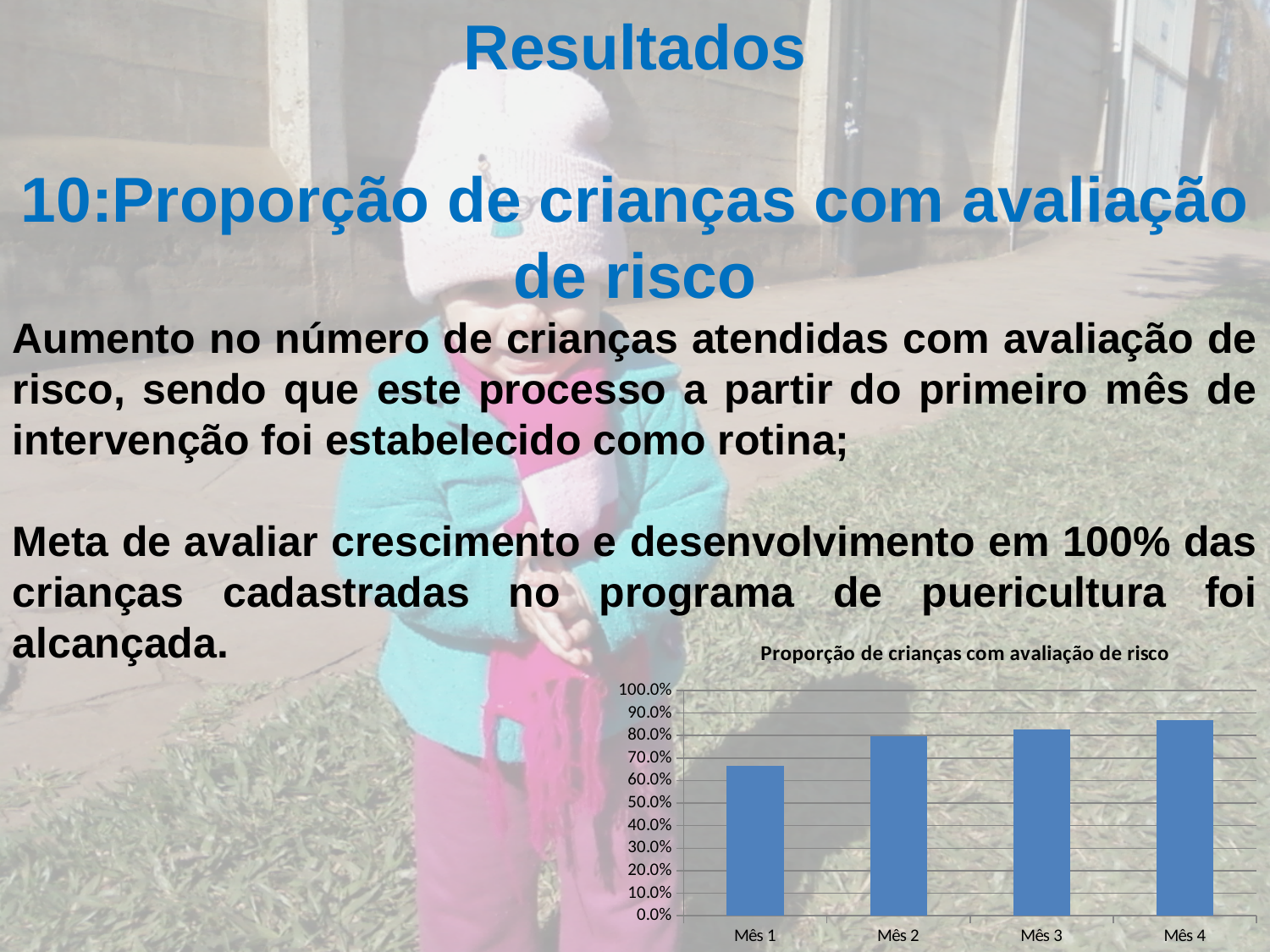
Which month has the highest proportion in the chart? Mês 4 How many categories (months) are plotted in the chart? 4 Is the value for Mês 1 greater or less than 60.0%? greater What is the title of the chart on the slide? Proporção de crianças com avaliação de risco Do the values rise or fall from Mês 1 to Mês 4? rise What kind of chart is shown on the slide? bar chart Is the value for Mês 1 greater or less than 70.0%? less Is the value for Mês 3 greater or less than 70.0%? greater Which is larger, the value for Mês 1 or the value for Mês 2? Mês 2 Which month has the lowest proportion in the chart? Mês 1